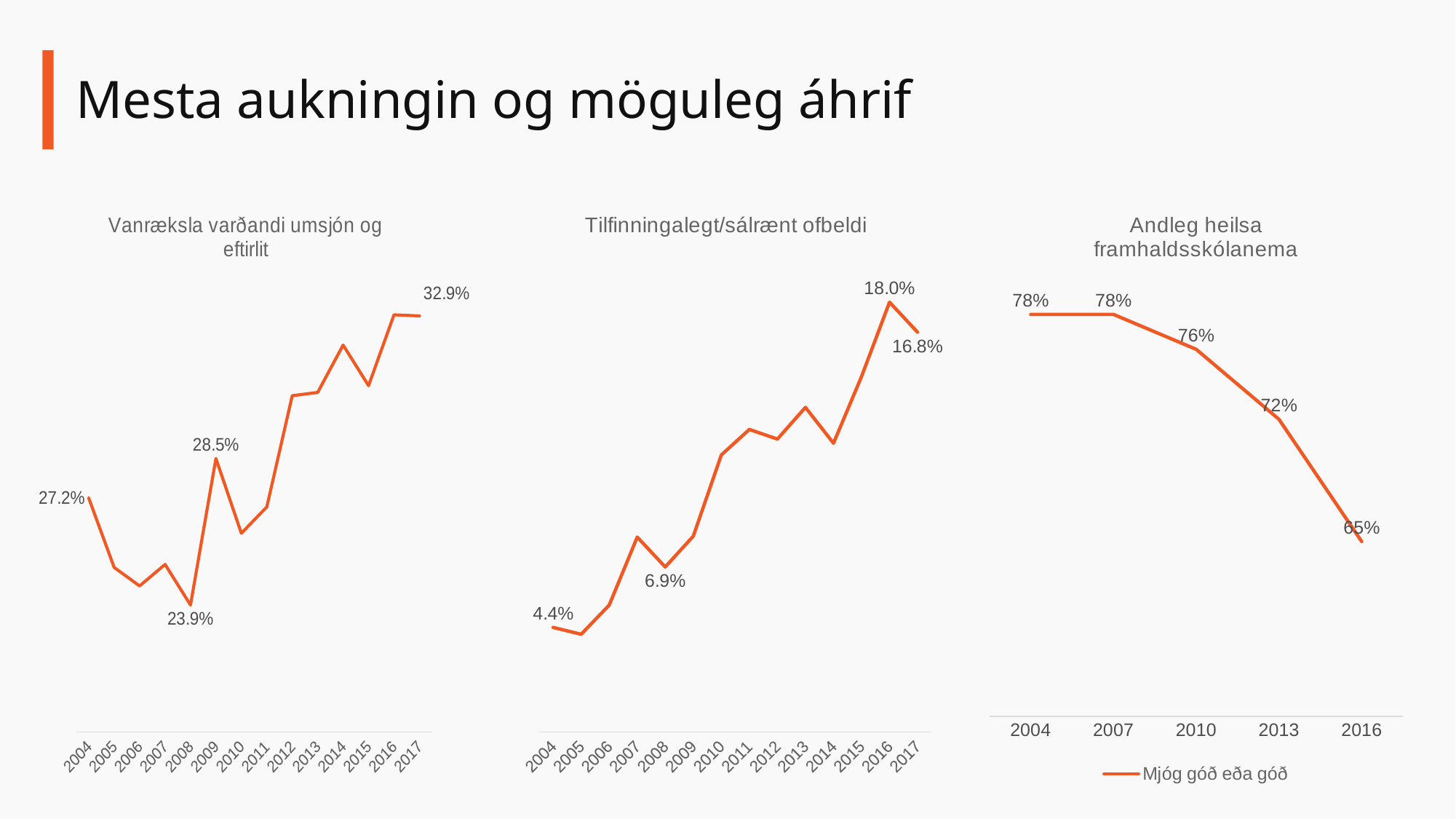
In the chart titled 'Andleg heilsa framhaldsskólanema', what is the value for 2010? 76% In the chart titled 'Andleg heilsa framhaldsskólanema', do the values rise or fall from 2004 to 2016? fall In the chart titled 'Tilfinningalegt/sálrænt ofbeldi', which year has the highest value? 2016 In the chart titled 'Tilfinningalegt/sálrænt ofbeldi', what is the value for 2004? 4.4% In the chart titled 'Tilfinningalegt/sálrænt ofbeldi', what is the difference between the 2016 value and the 2017 value? 1.2 percentage points In the chart titled 'Tilfinningalegt/sálrænt ofbeldi', what is the value for 2016? 18.0% In the chart titled 'Vanræksla varðandi umsjón og eftirlit', is the value for 2004 larger or smaller than the value for 2009? smaller In the chart titled 'Vanræksla varðandi umsjón og eftirlit', what is the value for 2008? 23.9% In the chart titled 'Andleg heilsa framhaldsskólanema', how many years are plotted? 5 In the chart titled 'Andleg heilsa framhaldsskólanema', what is the value for 2016? 65% In the chart titled 'Andleg heilsa framhaldsskólanema', what is the difference between the 2004 value and the 2016 value? 13 percentage points In the chart titled 'Andleg heilsa framhaldsskólanema', which year has the lowest value? 2016